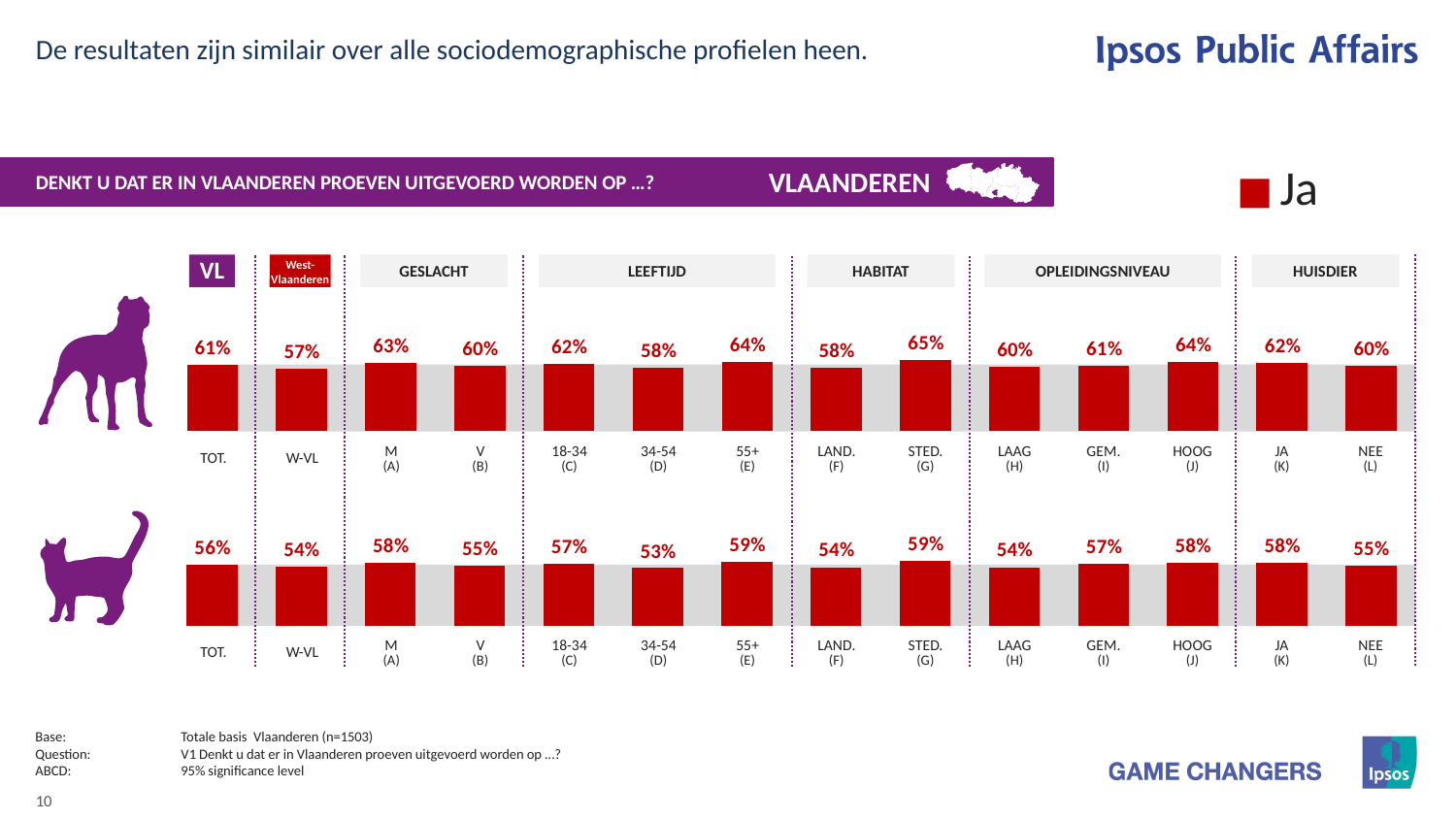
In the top chart (dog row), what is the difference between M (A) and V (B)? 3% In the top chart (dog row), what is the value for TOT.? 61% In the bottom chart (cat row), what is the value for 34-54 (D)? 53% In the bottom chart (cat row), which is larger, LAAG (H) or HOOG (J)? HOOG (J) In the top chart (dog row), what is the value for STED. (G)? 65% What is the legend entry shown on the slide? Ja In the bottom chart (cat row), which category has the lowest value? 34-54 (D) How many series does the legend list? 1 In the bottom chart (cat row), what is the value for W-VL? 54% In the top chart (dog row), which category has the highest value? STED. (G) How many bars are plotted in the top chart (dog row)? 14 What kind of chart is used on this slide? Bar chart